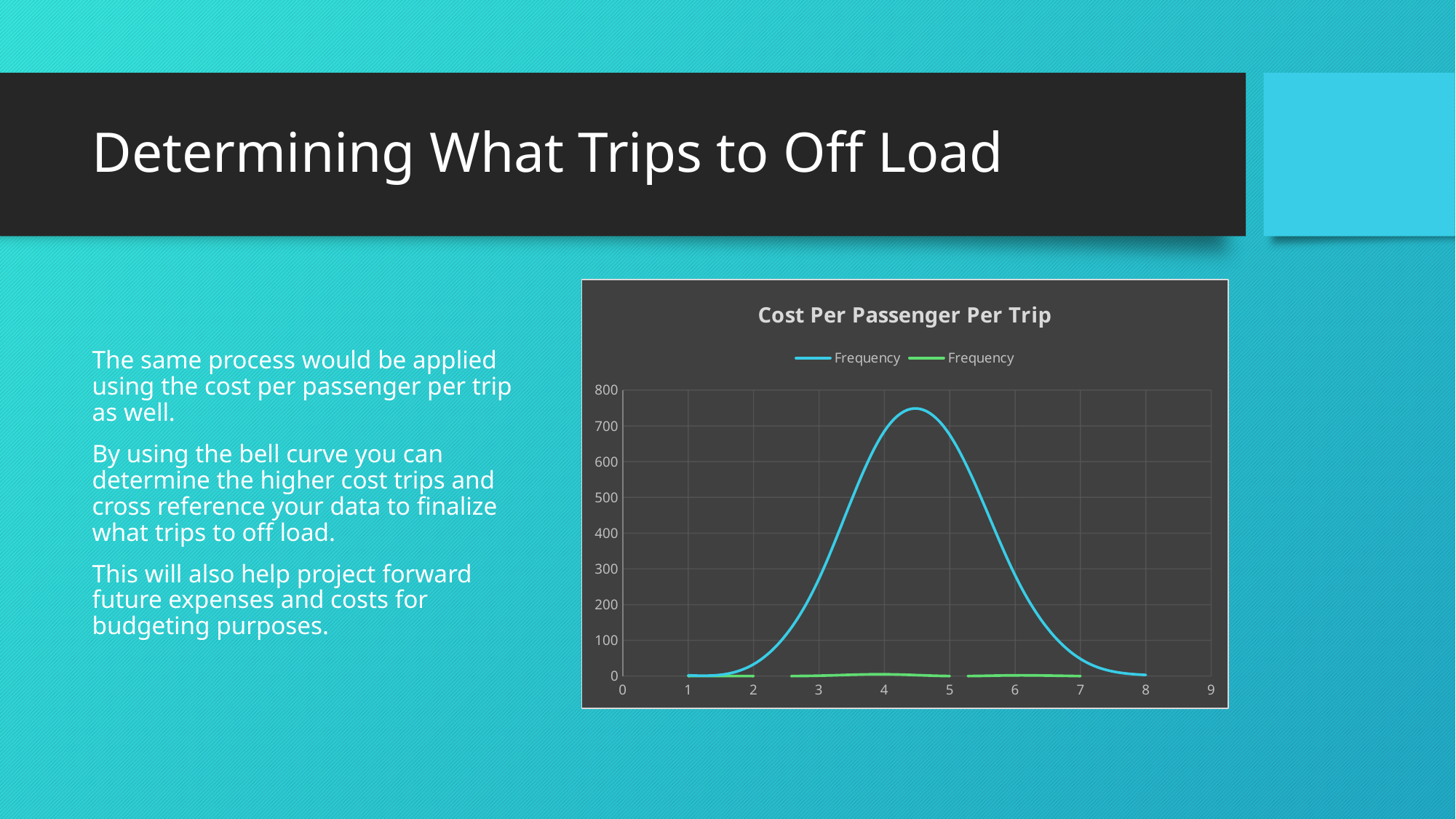
Is the value of the green Frequency curve at x = 4 greater or less than 100? less What is the highest value shown on the chart's vertical axis? 800 Is the value of the blue Frequency curve at x = 8 greater or less than 100? less What kind of chart is shown on the slide? line chart Does the blue Frequency curve rise or fall between x = 5 and x = 7? fall How many series does the chart's legend list? 2 Which series reaches higher values, the blue Frequency curve or the green Frequency curve? the blue Frequency curve Does the blue Frequency curve rise or fall between x = 2 and x = 4? rise What label is given to both series in the legend? Frequency What is the title of the chart? Cost Per Passenger Per Trip Is the value of the blue Frequency curve at x = 1 greater or less than 100? less